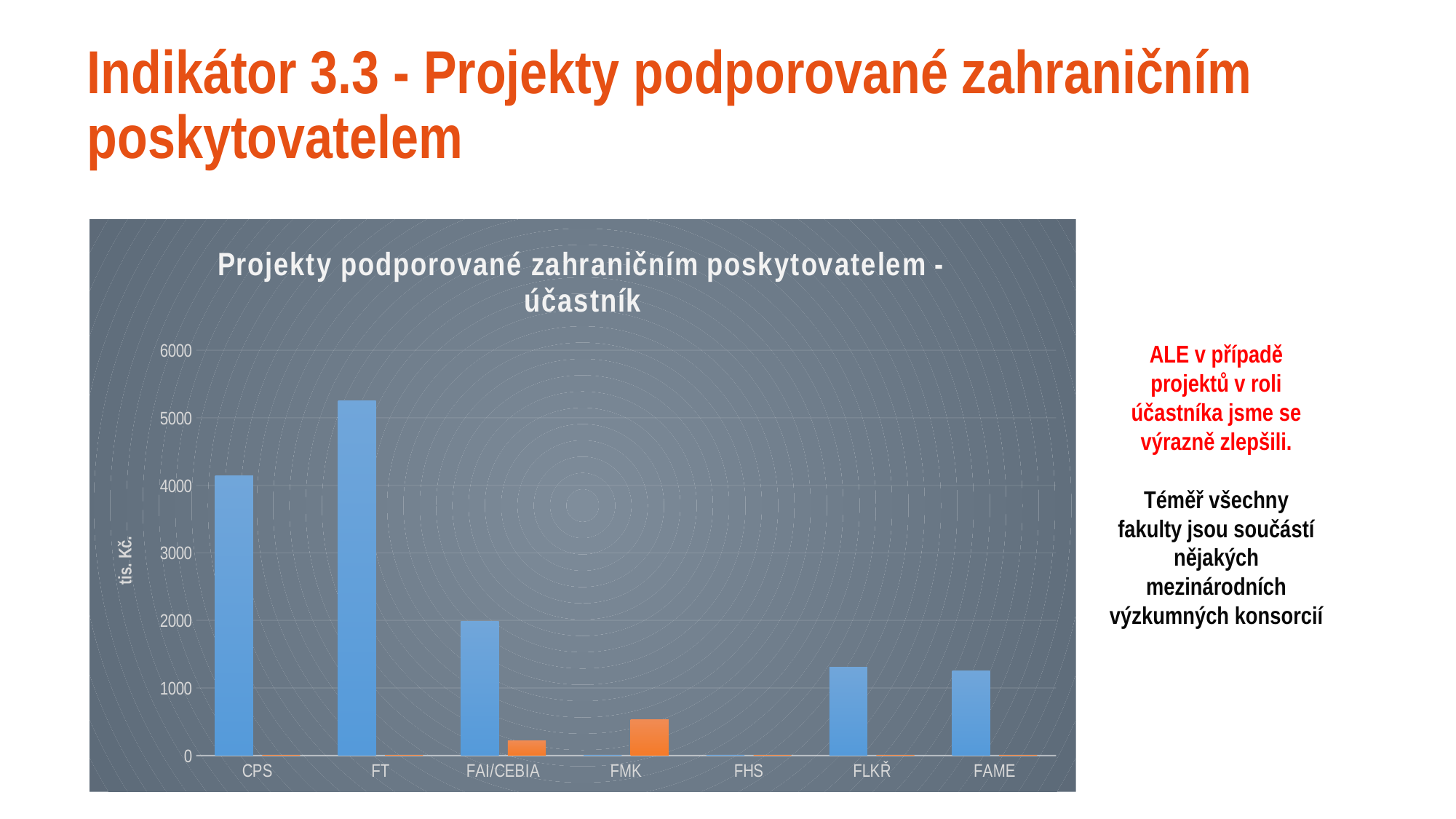
What is the label of the vertical axis? tis. Kč. How many categories are shown on the x axis? 7 What kind of chart is shown on the slide? bar chart Which category has the tallest blue bar? FT Which has the larger blue bar, FT or FAI/CEBIA? FT Is the blue bar for FAI/CEBIA greater or less than 3000? less Is the blue bar for CPS greater or less than 4000? greater Which has the larger blue bar, CPS or FT? FT Is the orange bar for FMK greater or less than 1000? less What is the title of the chart? Projekty podporované zahraničním poskytovatelem - účastník